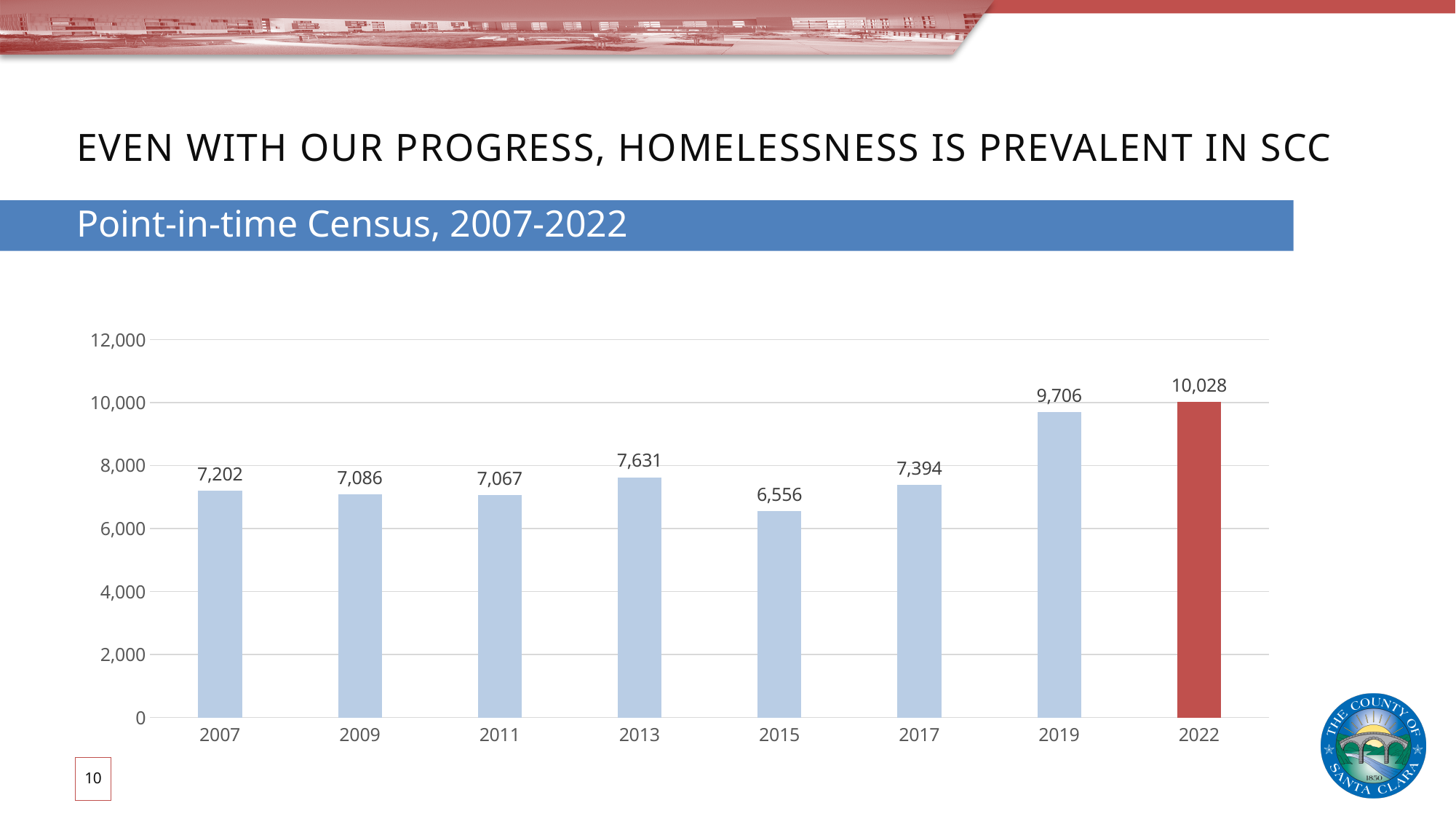
What is the point-in-time census value for 2022? 10,028 How many years are shown on the x axis of the chart? 8 Which year has the highest point-in-time census value? 2022 What is the difference between the 2007 value and the 2015 value? 646 Which is larger, the value for 2013 or the value for 2017? 2013 What is the point-in-time census value for 2013? 7,631 Which year has the lowest point-in-time census value? 2015 What kind of chart is shown on the slide? Bar chart What is the point-in-time census value for 2015? 6,556 Which bar is coloured red rather than blue? 2022 Is the value for 2019 greater or less than 8,000? greater What is the difference between the 2022 value and the 2019 value? 322